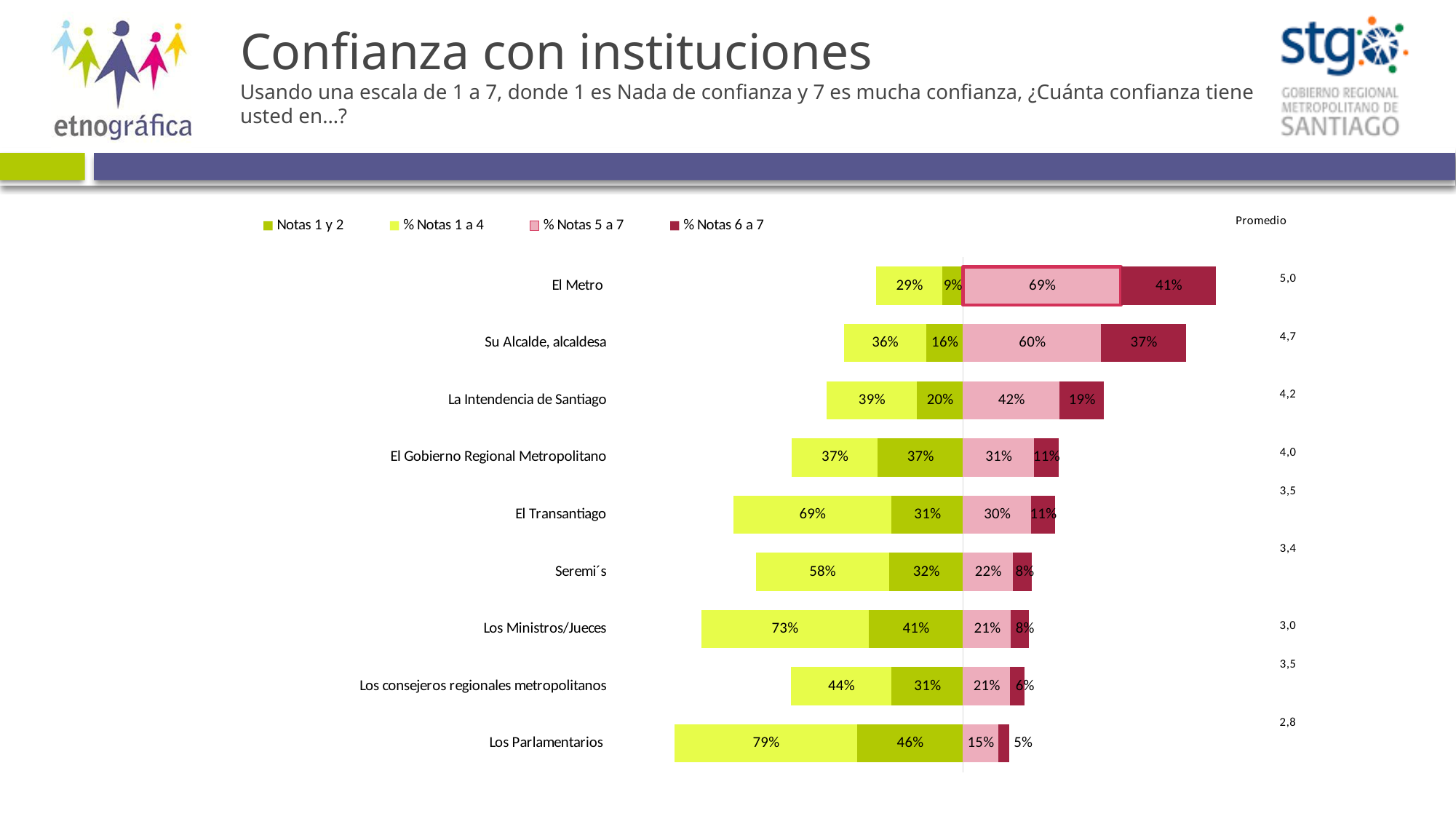
Which institution has the lowest % Notas 5 a 7 value? Los Parlamentarios What is the difference between the % Notas 5 a 7 values for El Metro and Su Alcalde, alcaldesa? 9% What is the Notas 1 y 2 value for Los Ministros/Jueces? 41% What kind of chart is shown on the slide? bar chart Which has a larger % Notas 1 a 4 value, El Transantiago or Seremi´s? El Transantiago What is the Promedio shown for La Intendencia de Santiago? 4,2 Which institution has the highest % Notas 6 a 7 value? El Metro What is the % Notas 1 a 4 value for Los Parlamentarios? 79% How many institutions are plotted in the chart? 9 What is the % Notas 6 a 7 value for Su Alcalde, alcaldesa? 37% How many series does the legend list? 4 What is the % Notas 5 a 7 value for El Metro? 69%